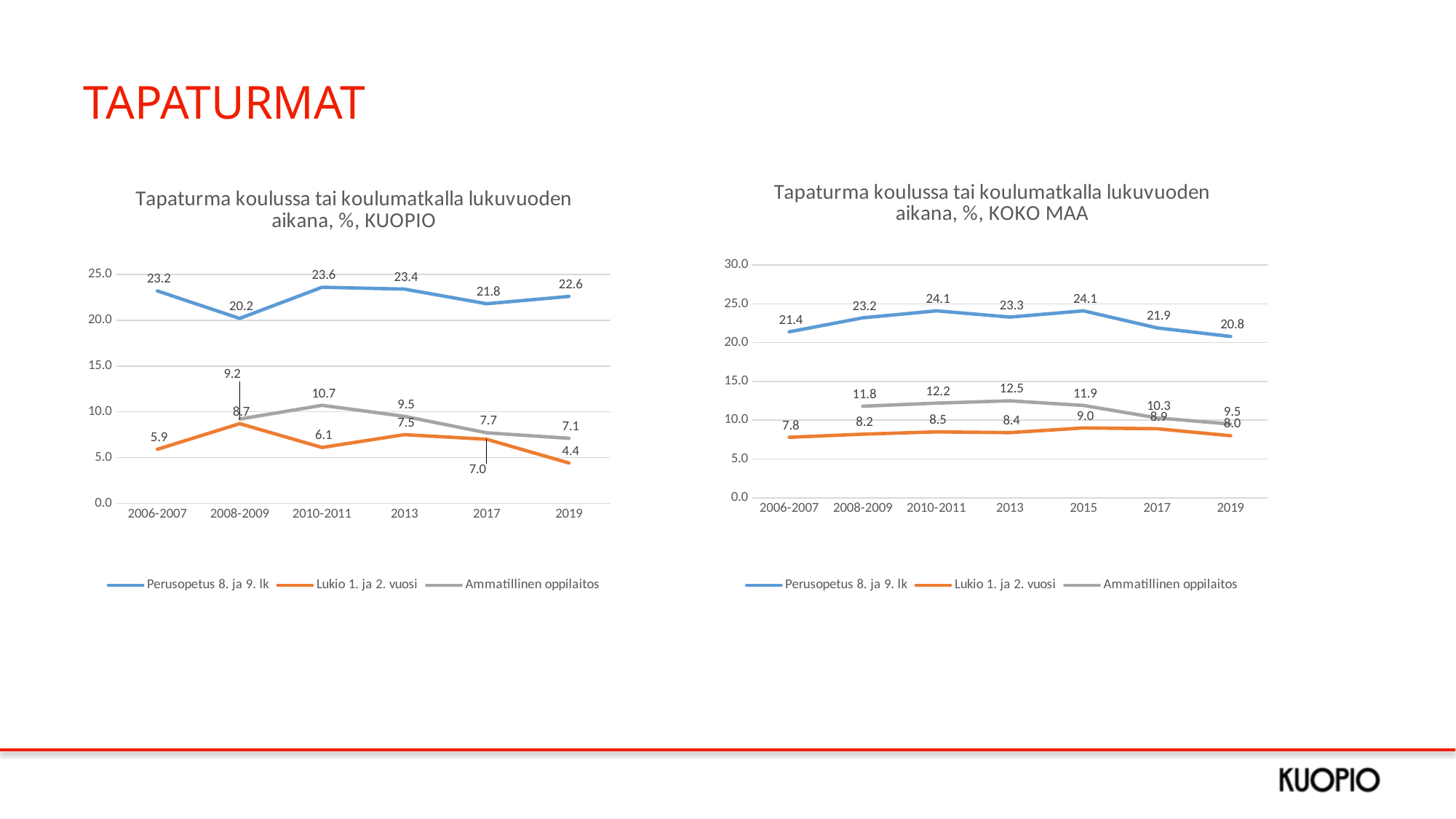
In the KUOPIO chart, how many series does the legend list? 3 In the KUOPIO chart, in which year is the Lukio 1. ja 2. vuosi value lowest? 2019 In the KUOPIO chart, what is the value for Perusopetus 8. ja 9. lk in 2010-2011? 23.6 In the KOKO MAA chart, in which year is the Perusopetus 8. ja 9. lk value lowest? 2019 In the KUOPIO chart, what is the value for Lukio 1. ja 2. vuosi in 2019? 4.4 In the KOKO MAA chart, what is the value for Ammatillinen oppilaitos in 2013? 12.5 In the KOKO MAA chart, what is the value for Lukio 1. ja 2. vuosi in 2015? 9.0 In the KOKO MAA chart, is the Perusopetus 8. ja 9. lk value in 2006-2007 greater or less than 25.0? less What kind of chart is the KUOPIO chart? line chart In the KOKO MAA chart, which is larger in 2019: Ammatillinen oppilaitos or Lukio 1. ja 2. vuosi? Ammatillinen oppilaitos In the KOKO MAA chart, how many categories are shown on the x axis? 7 In the KUOPIO chart, what is the difference between the Perusopetus 8. ja 9. lk values in 2010-2011 and 2008-2009? 3.4